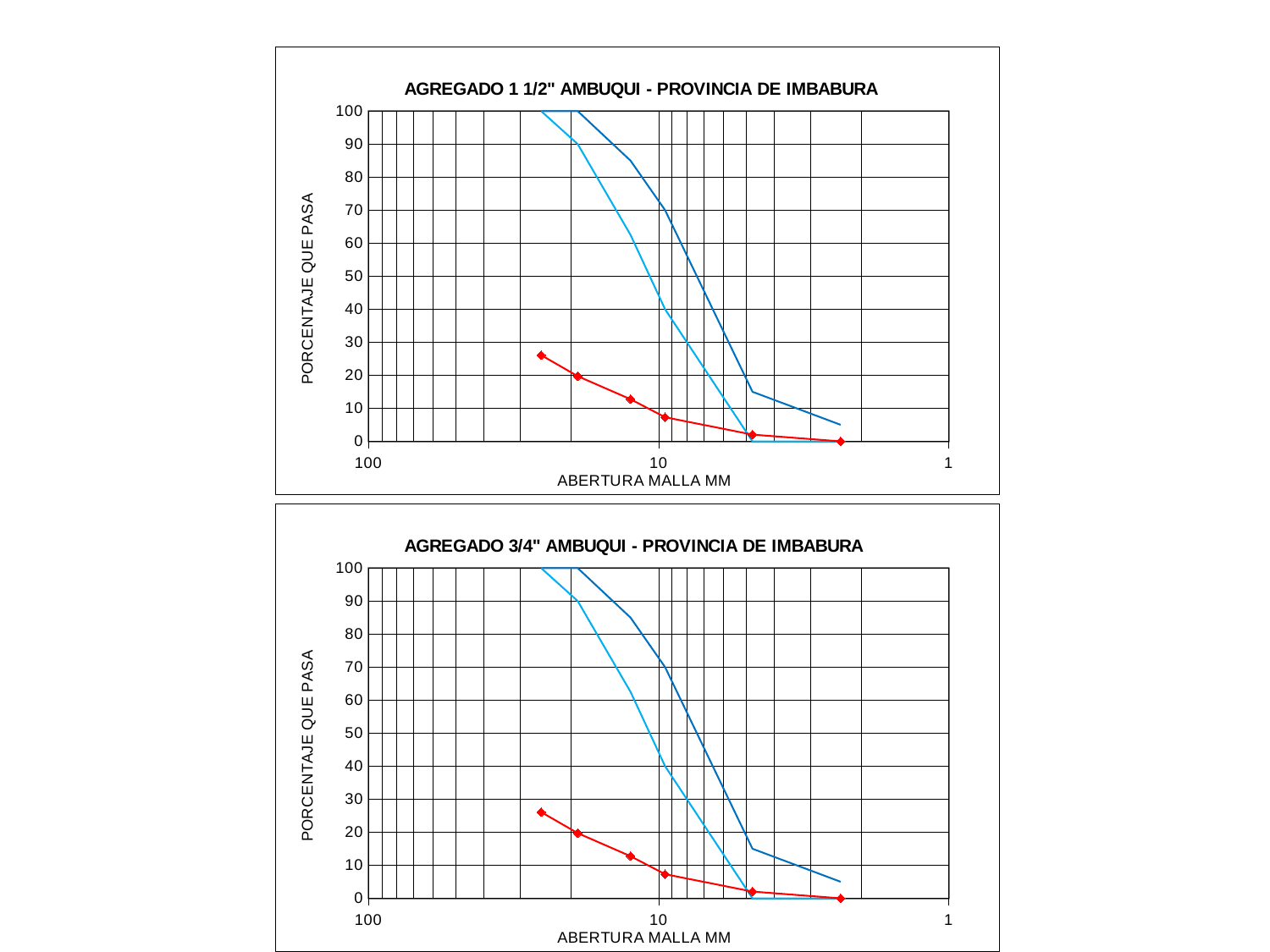
What kind of chart is the top chart, 'AGREGADO 1 1/2" AMBUQUI - PROVINCIA DE IMBABURA'? Line chart In the top chart, is the value of the leftmost red data point greater or less than 20? Greater In the top chart, at an opening of 10 mm, which line is higher: the dark blue line or the light blue line? The dark blue line In the bottom chart, is the value of the rightmost red data point greater or less than 10? Less In the bottom chart, do the values of the dark blue line rise or fall moving from left to right along the x axis? Fall In the bottom chart, which of the three lines has the lowest values across the plotted range? The red line In the bottom chart, how many marked data points does the red line have? 6 In the top chart, do the values of the red line rise or fall moving from left to right along the x axis? Fall What is the title of the bottom chart on the slide? AGREGADO 3/4" AMBUQUI - PROVINCIA DE IMBABURA In the top chart, is the value of the rightmost point of the dark blue line greater or less than 10? Less In the top chart, what is the label of the vertical axis? PORCENTAJE QUE PASA In the top chart, how many marked data points does the red line have? 6